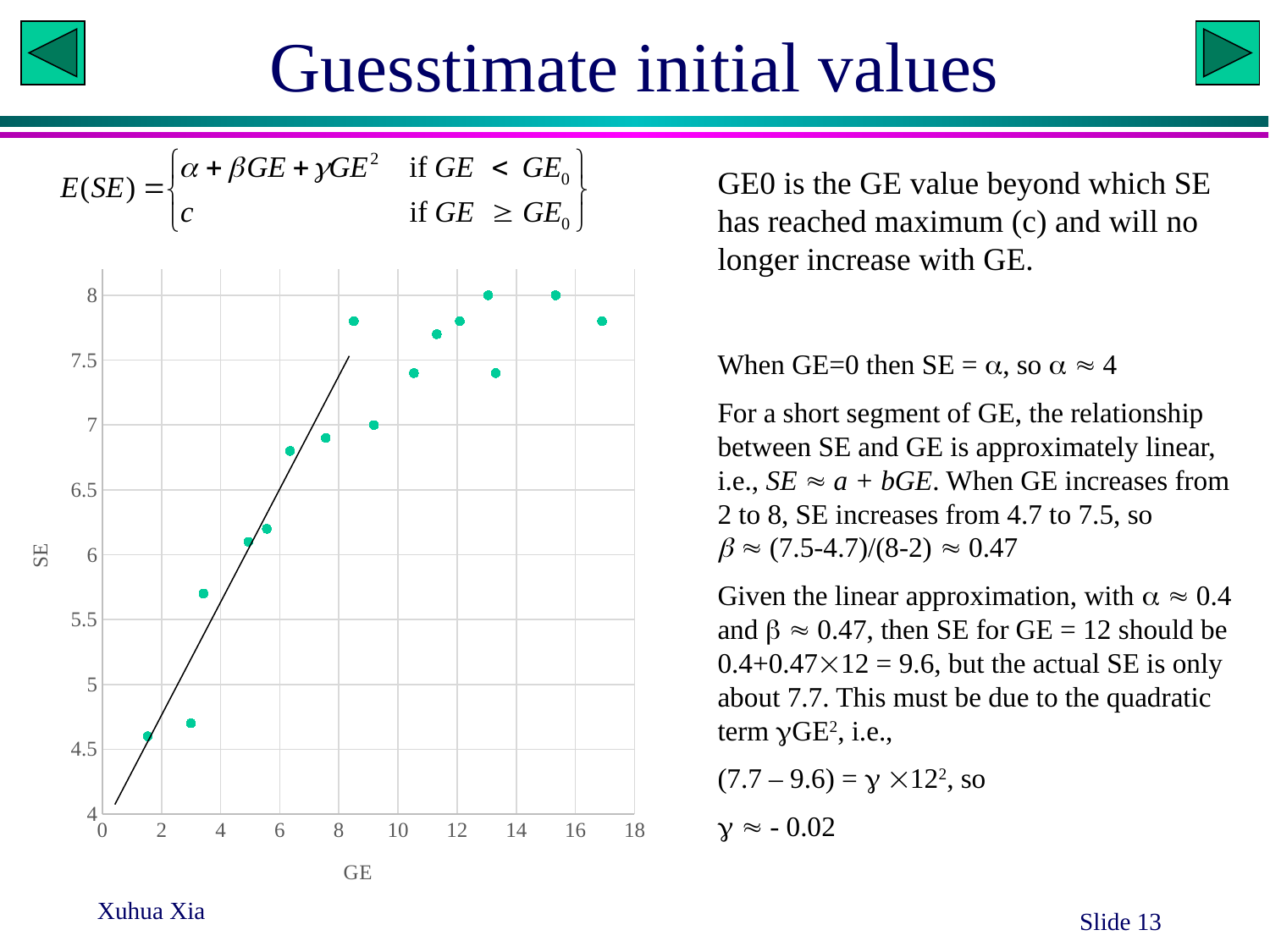
What is the label of the y axis of the chart? SE What is the highest value shown on the x axis of the chart? 18 Do the SE values generally rise or fall as GE increases from 0 to 8? rise Is the SE value for the point near GE = 15 greater or less than 7.5? greater Is the SE value for the point near GE = 9 greater or less than 6.5? greater Is the SE value for the point near GE = 5 greater or less than 6.5? less What kind of chart is shown on the slide? scatter chart What is the label of the x axis of the chart? GE Which has the larger SE value: the point near GE = 3.5 or the point near GE = 12? the point near GE = 12